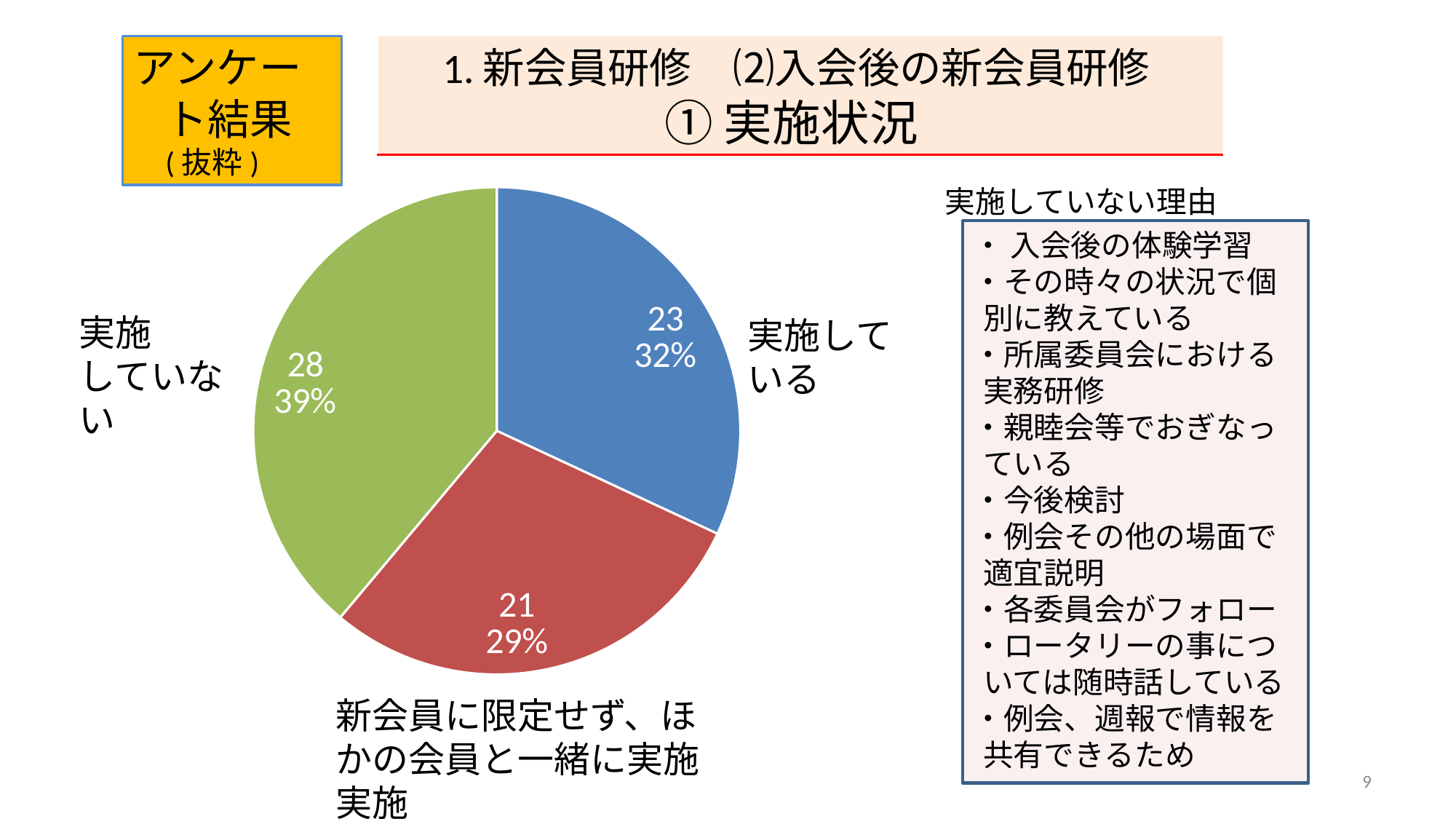
What percentage is shown for 実施していない? 39% Which category has the largest slice in the pie chart? 実施していない What kind of chart is shown on the slide? Pie chart What is the count for 実施している in the pie chart? 23 How many slices does the pie chart have? 3 Which category has the smallest slice in the pie chart? 新会員に限定せず、ほかの会員と一緒に実施 What percentage is shown for 実施している? 32% Which is larger, the count for 実施している or the count for 新会員に限定せず、ほかの会員と一緒に実施? 実施している What is the count for 新会員に限定せず、ほかの会員と一緒に実施? 21 What colour is the 実施していない slice? Green What is the difference in count between 実施していない and 実施している? 5 What is the total count across all three slices of the pie chart? 72